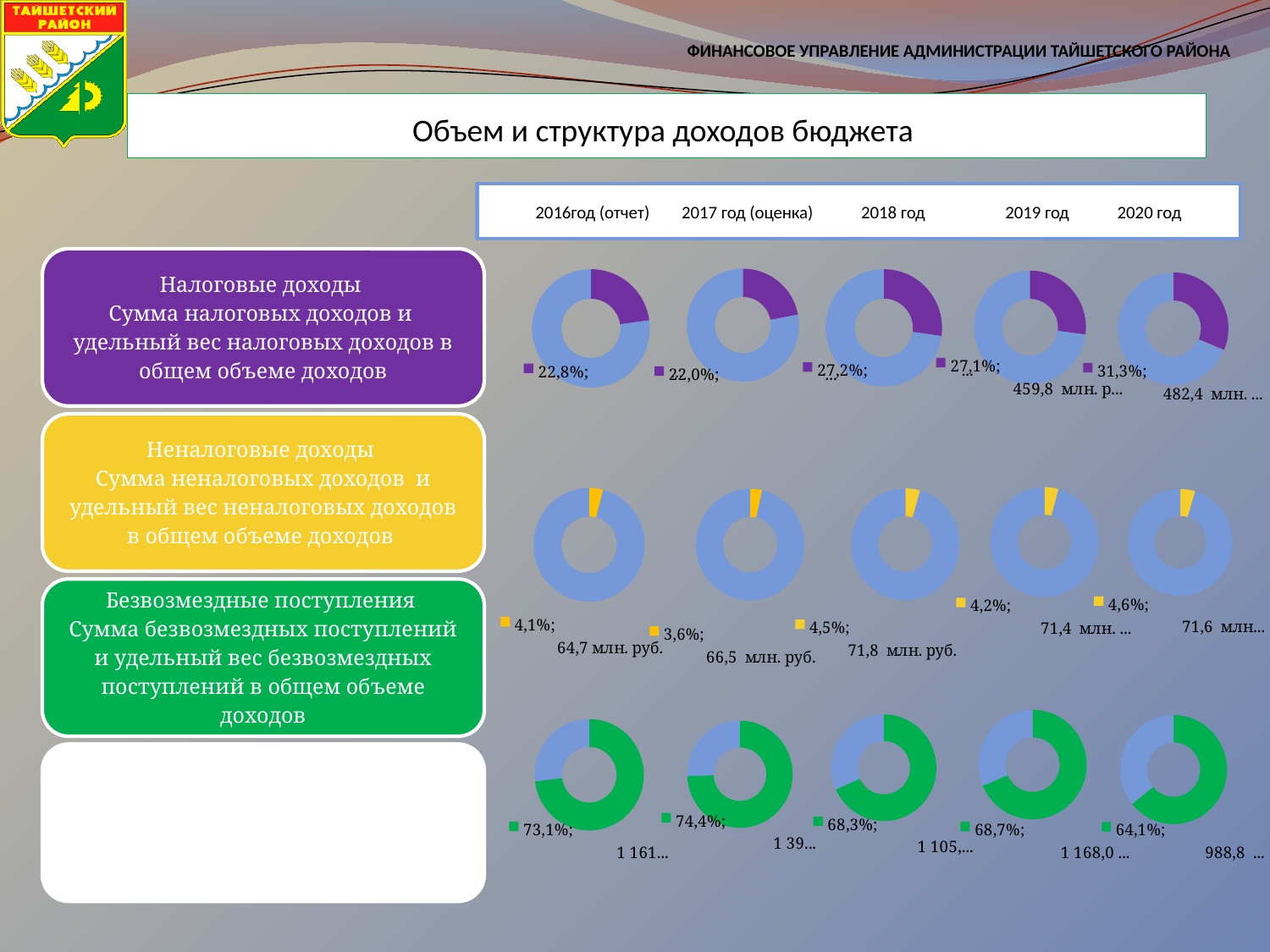
In the tax revenues row (top row), which year has the highest tax revenue share? 2020 In the gratuitous receipts row (bottom row), which is larger: the share for 2018 or the share for 2019? 2019 In the gratuitous receipts row (bottom row), what share is shown for 2017 (оценка)? 74,4% In the non-tax revenues row (middle row), what amount in million rubles is shown for 2016? 64,7 млн. руб. In the tax revenues row (top row), what share is shown for 2020? 31,3% How many pie charts are shown in the tax revenues row (top row)? 5 In the tax revenues row (top row), what is the difference between the 2020 share and the 2016 share? 8,5% In the tax revenues row (top row), what share of total revenues do tax revenues make up in 2016 (отчет)? 22,8% In the gratuitous receipts row (bottom row), which year has the lowest share of gratuitous receipts? 2020 What type of chart is used to show the revenue structure on this slide? doughnut chart In the non-tax revenues row (middle row), what share is shown for 2018? 4,5% In the non-tax revenues row (middle row), which year has the lowest non-tax share? 2017